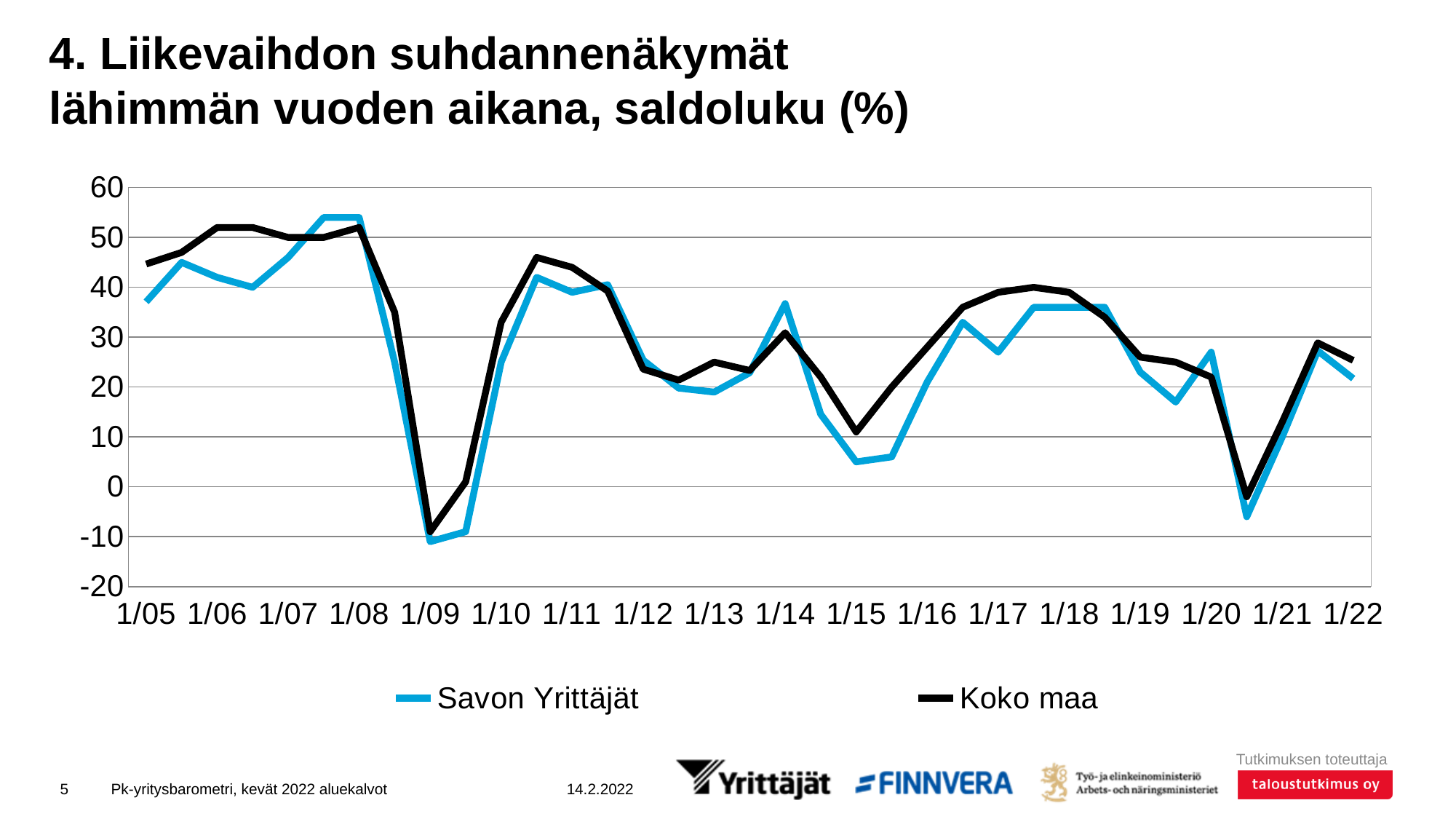
At 1/14, which series has the higher value, Savon Yrittäjät or Koko maa? Savon Yrittäjät At 1/05, which series has the higher value, Savon Yrittäjät or Koko maa? Koko maa What colour is the line for Savon Yrittäjät? blue Is the value for Savon Yrittäjät at 1/08 greater or less than 50? greater How many labels are shown on the x axis? 18 At which x-axis label is the Savon Yrittäjät line at its lowest? 1/09 What kind of chart is shown on the slide? line chart Is the value for Savon Yrittäjät at 1/09 greater or less than 0? less Which two series are listed in the legend? Savon Yrittäjät and Koko maa How many series does the legend list? 2 At which x-axis label is the Koko maa line at its lowest? 1/09 Is the value for Savon Yrittäjät at 1/15 greater or less than 10? less